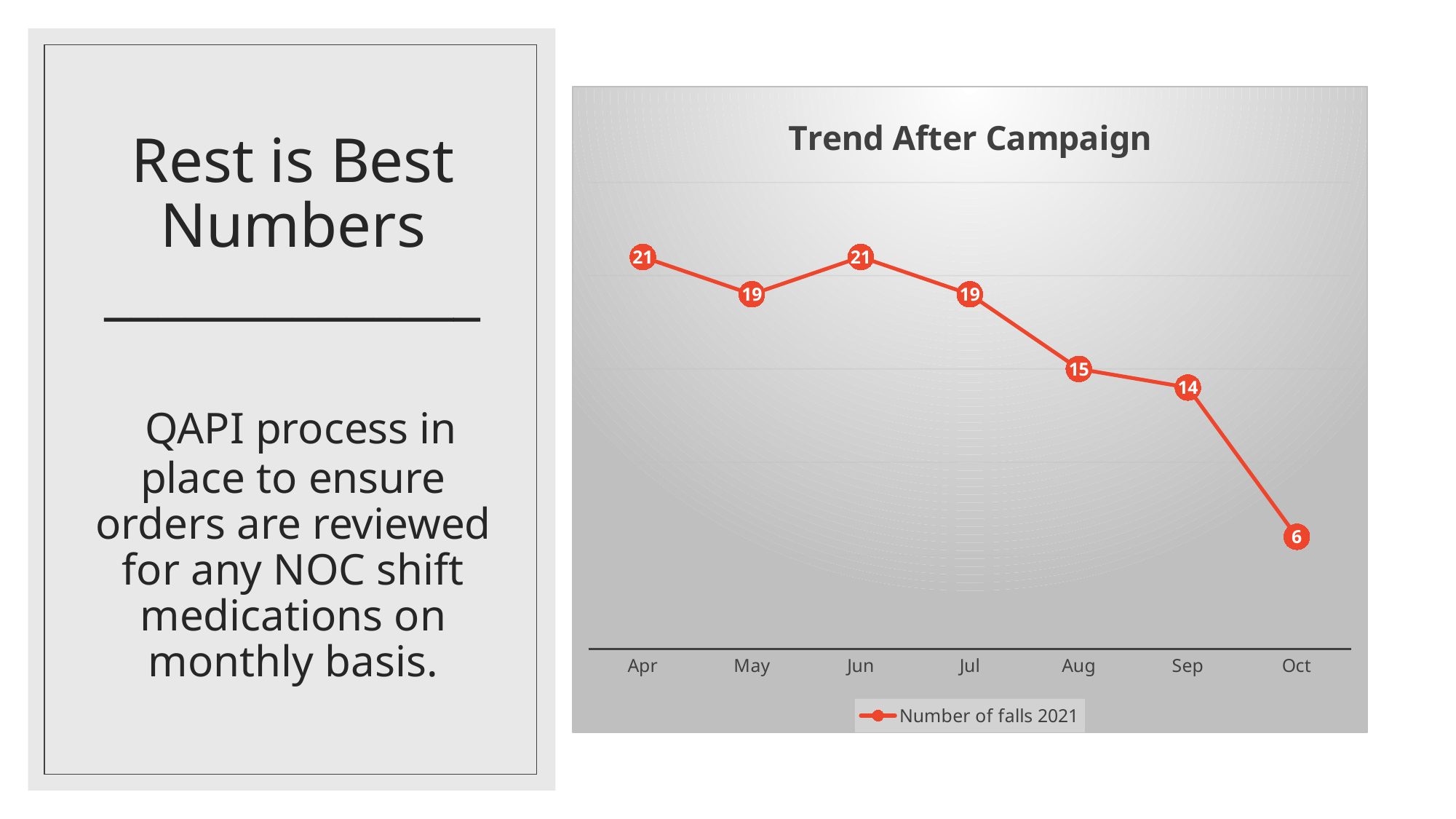
How many series does the legend list? 1 What is the number of falls in Aug? 15 What kind of chart is shown? Line chart How many months are plotted on the chart? 7 What is the difference in the number of falls between Apr and Aug? 6 Do the values generally rise or fall from Apr to Oct? Fall What is the number of falls in Oct? 6 What is the title of the chart? Trend After Campaign What is the difference in the number of falls between Sep and Oct? 8 What is the number of falls in May? 19 Which month has the lowest number of falls? Oct Which month has more falls, Jul or Sep? Jul